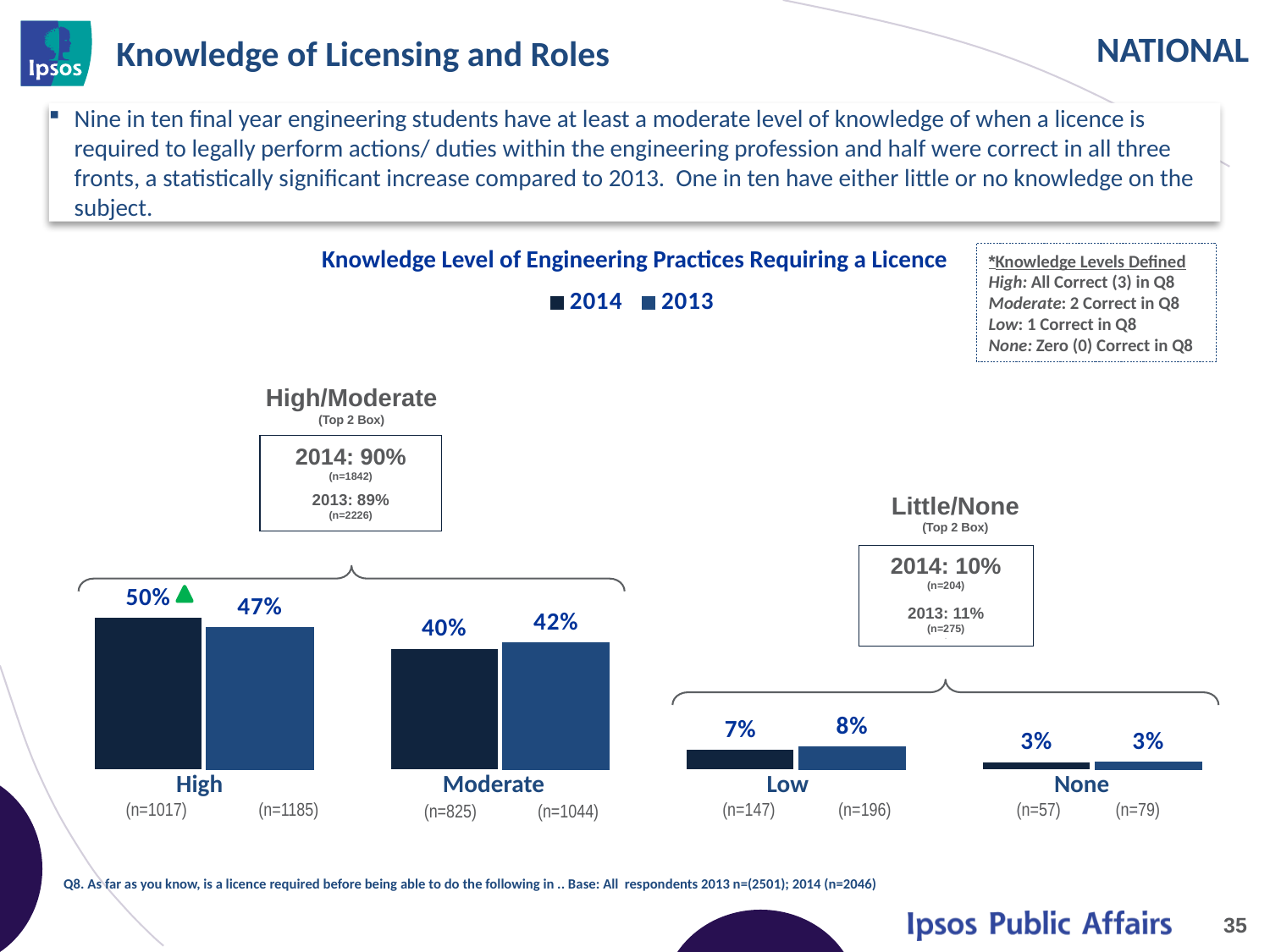
What is the 2014 value for the Low category? 7% How many categories are shown on the x axis of the chart? 4 What is the title of the chart? Knowledge Level of Engineering Practices Requiring a Licence Which category has the highest 2014 value? High What kind of chart is shown on the slide? Bar chart What is the 2014 value for the High category? 50% Which is larger for the Moderate category, the 2014 value or the 2013 value? 2013 What is the difference between the 2014 and 2013 values for the High category? 3% Which category has the lowest 2013 value? None What is the 2013 value for the None category? 3% How many series does the legend list? 2 What is the 2013 value for the Moderate category? 42%